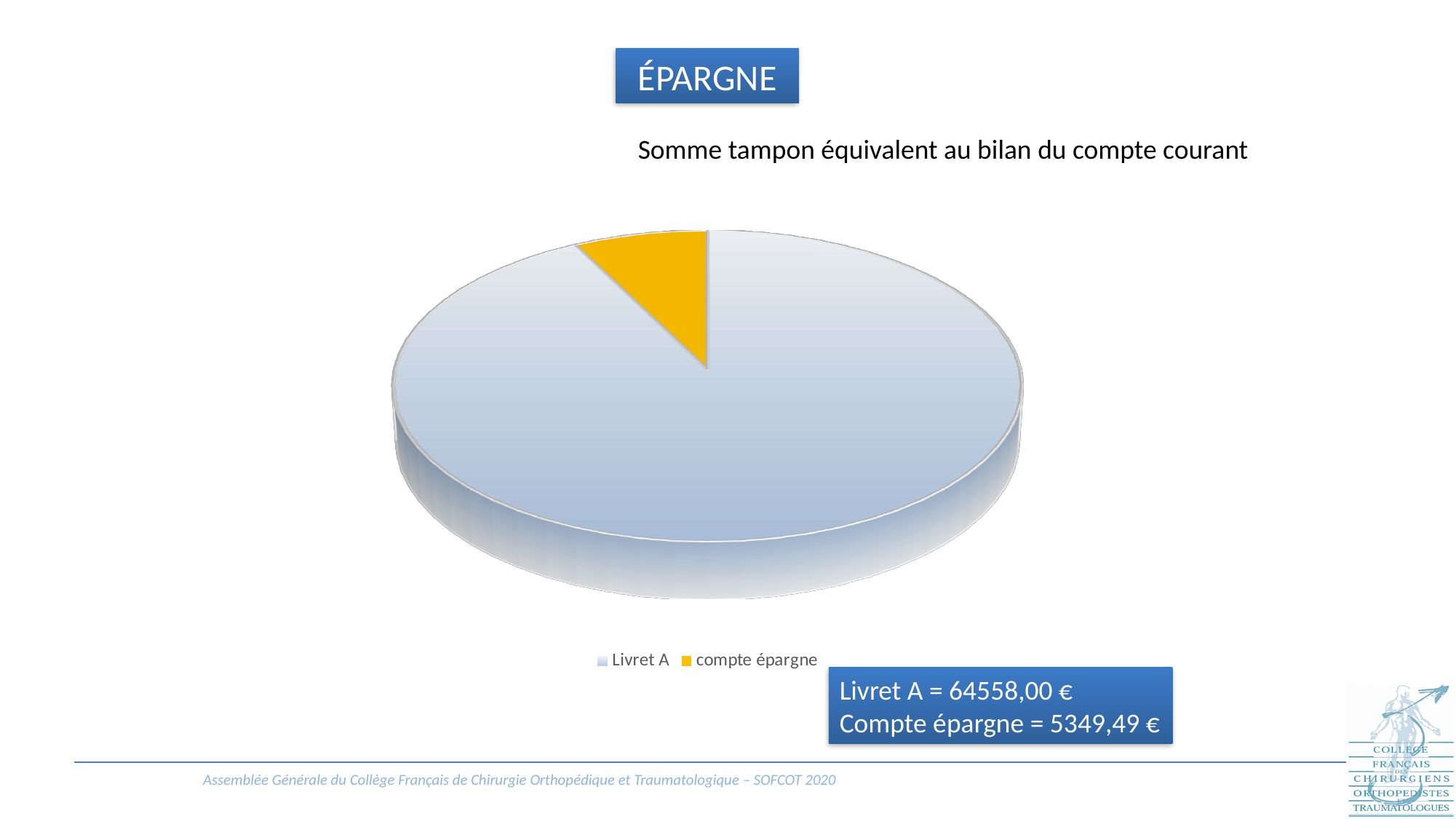
Which is larger, Livret A or compte épargne? Livret A What is the difference between the Livret A value and the Compte épargne value? 59208,51 € Which category has the largest slice of the pie chart? Livret A Which category has the smallest slice of the pie chart? compte épargne What is the total of Livret A and Compte épargne combined? 69907,49 € How many slices does the pie chart have? 2 What kind of chart is shown on the slide? pie chart What is the value for Livret A? 64558,00 € What is the heading written above the pie chart? Somme tampon équivalent au bilan du compte courant What is the value for Compte épargne? 5349,49 € How many entries does the legend of the pie chart list? 2 What colour is the compte épargne slice in the pie chart? yellow